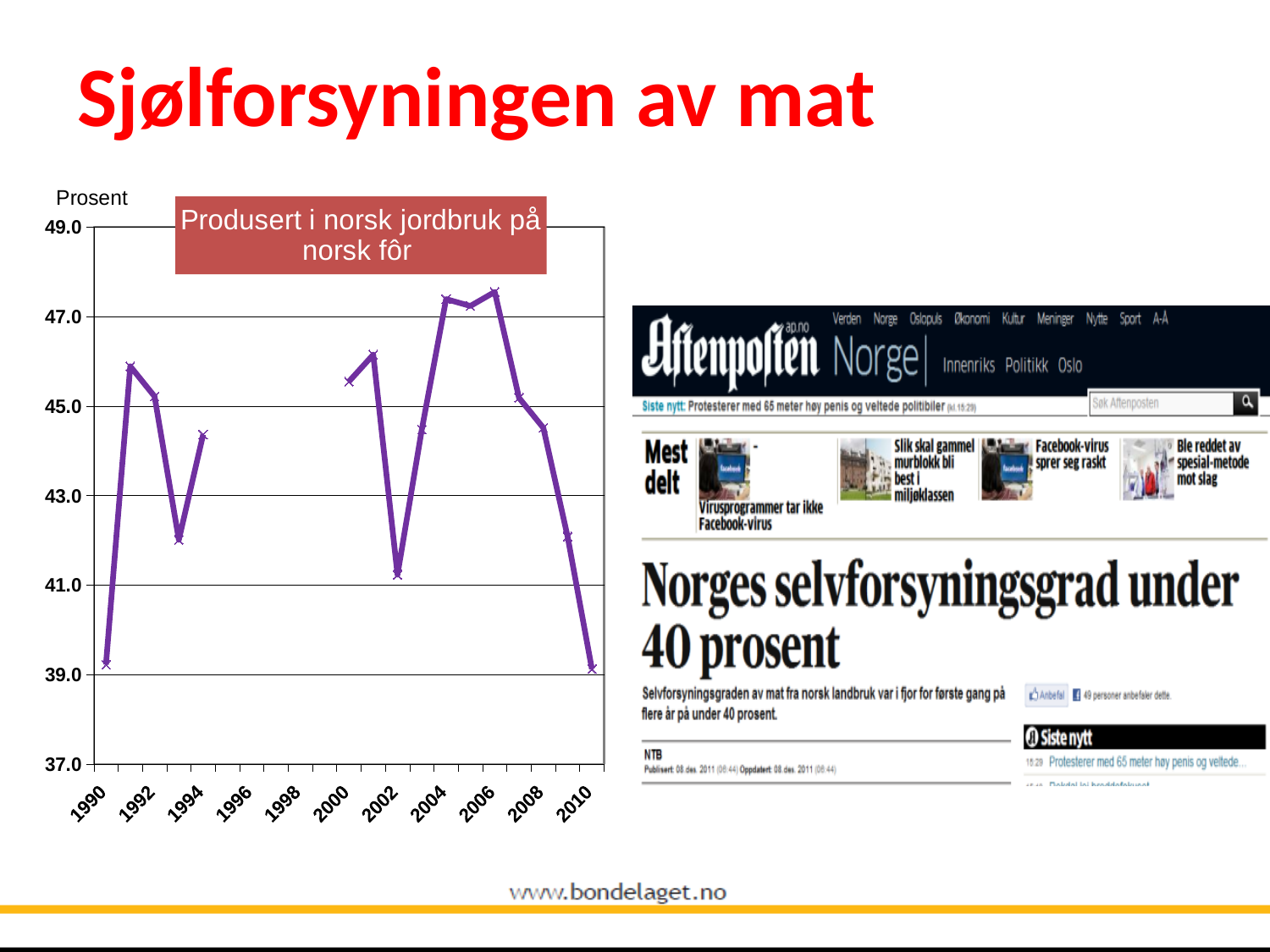
Is the value for 1990 greater or less than 41.0? less What is the label shown above the vertical axis of the chart? Prosent Is the value for 2002 greater or less than 43.0? less Do the values rise or fall from 2006 to 2010? fall Is the value for 2000 greater or less than 45.0? greater Which year has the larger value, 1990 or 1992? 1992 Which year has the larger value, 2006 or 2002? 2006 What text is shown in the box at the top of the chart? Produsert i norsk jordbruk på norsk fôr What kind of chart is shown on the slide? line chart